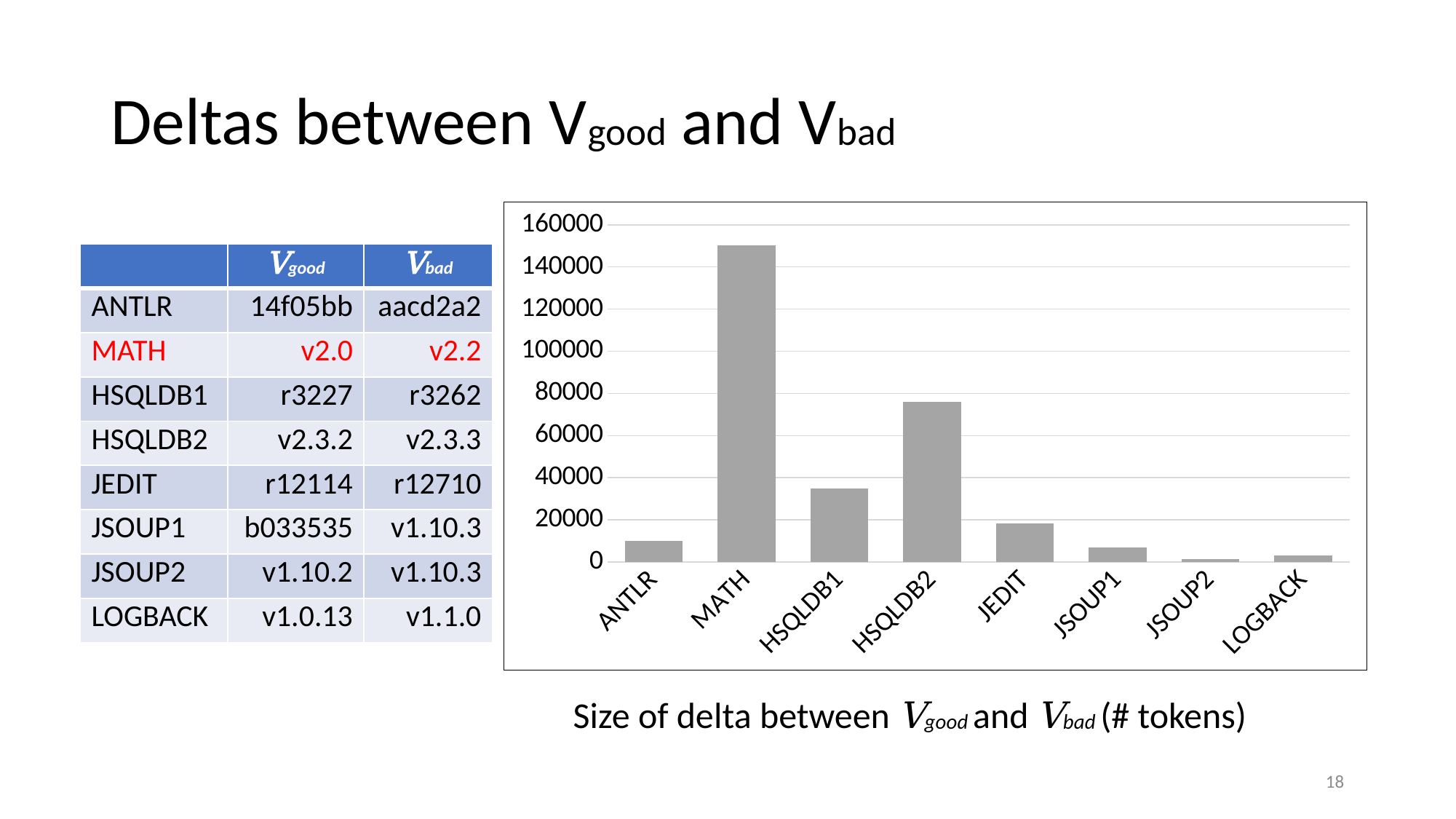
Which is larger, the value for JEDIT or the value for JSOUP1? JEDIT Is the value for ANTLR greater or less than 20000? less Which category has the lowest bar in the chart? JSOUP2 What kind of chart is shown on the slide? bar chart Is the value for HSQLDB2 greater or less than 60000? greater Which category has the highest bar in the chart? MATH Is the value for HSQLDB1 greater or less than 40000? less What is the highest tick value shown on the y axis of the chart? 160000 How many categories are plotted on the x axis of the chart? 8 Which is larger, the value for HSQLDB2 or the value for HSQLDB1? HSQLDB2